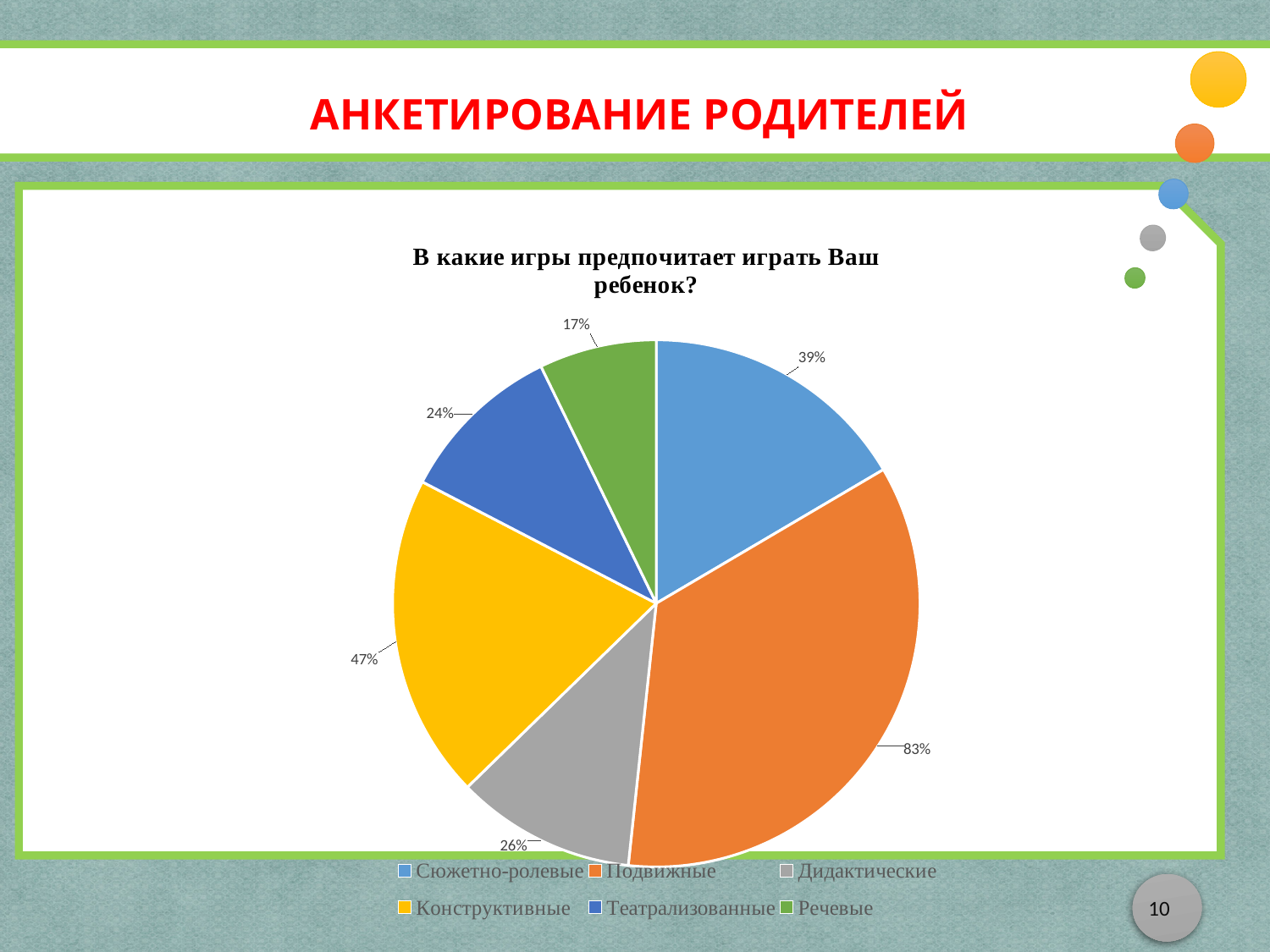
What is the title of the chart? В какие игры предпочитает играть Ваш ребенок? What value is shown for Подвижные? 83% What value is shown for Конструктивные? 47% Which category has the lowest value? Речевые Which is larger, the value for Дидактические or the value for Театрализованные? Дидактические What value is shown for Сюжетно-ролевые? 39% Which category has the highest value? Подвижные What value is shown for Речевые? 17% How many categories does the pie chart have? 6 What type of chart is shown on the slide? pie chart What is the difference between the values for Подвижные and Конструктивные? 36% What colour is the slice for Конструктивные? yellow